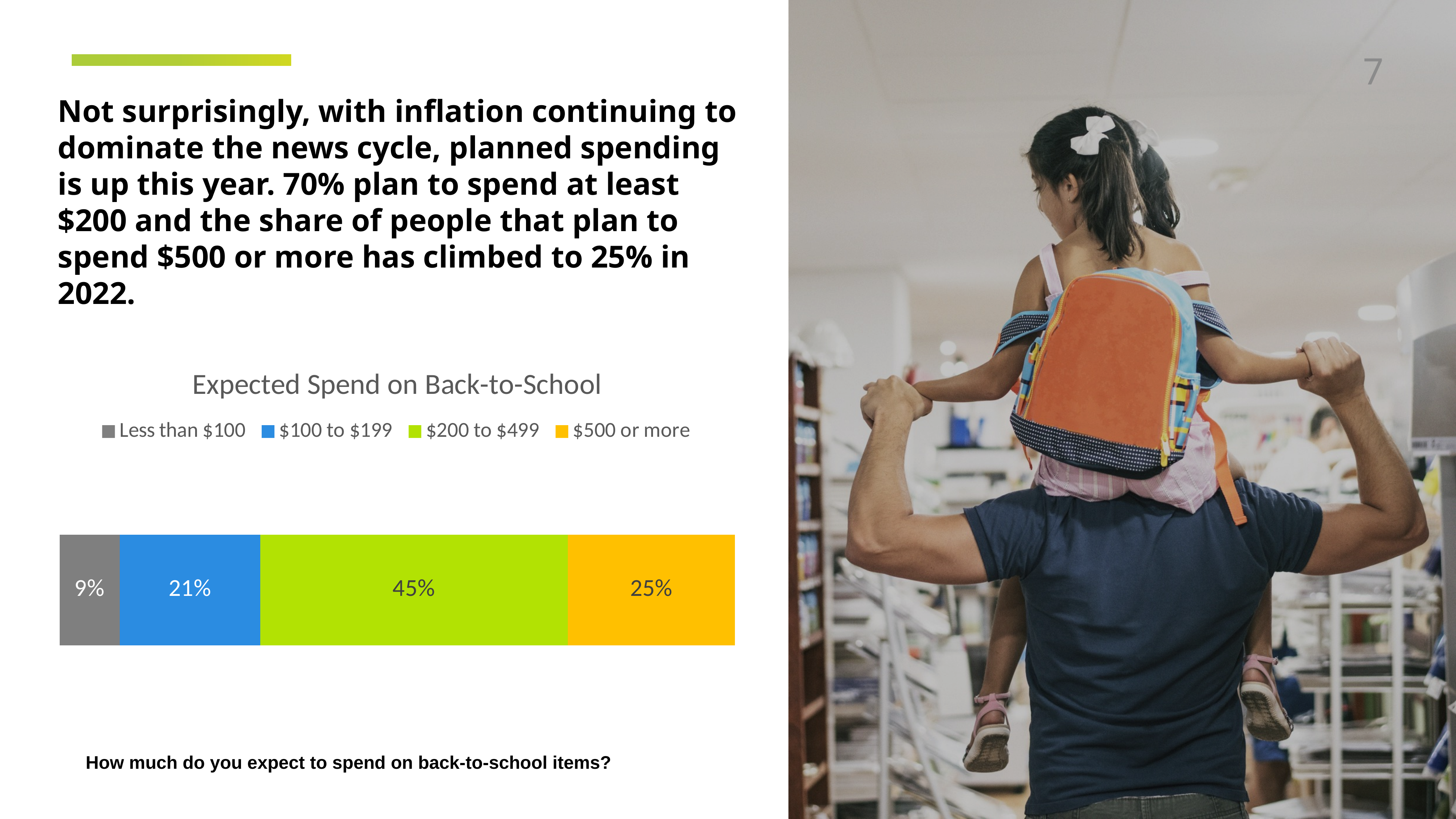
What is the title of the chart? Expected Spend on Back-to-School What is the value for the "$200 to $499" segment in the Expected Spend on Back-to-School chart? 45% Which spending range has the smallest share in the chart? Less than $100 What is the total of the stacked bar? 100% Which spending range has the largest share in the chart? $200 to $499 What is the value for the "$100 to $199" segment? 21% What is the value for the "Less than $100" segment? 9% How many series does the legend list? 4 Which is larger, the "$100 to $199" share or the "$500 or more" share? $500 or more What is the difference between the "$200 to $499" share and the "$500 or more" share? 20% What is the value for the "$500 or more" segment? 25% What kind of chart is shown on the slide? Stacked bar chart